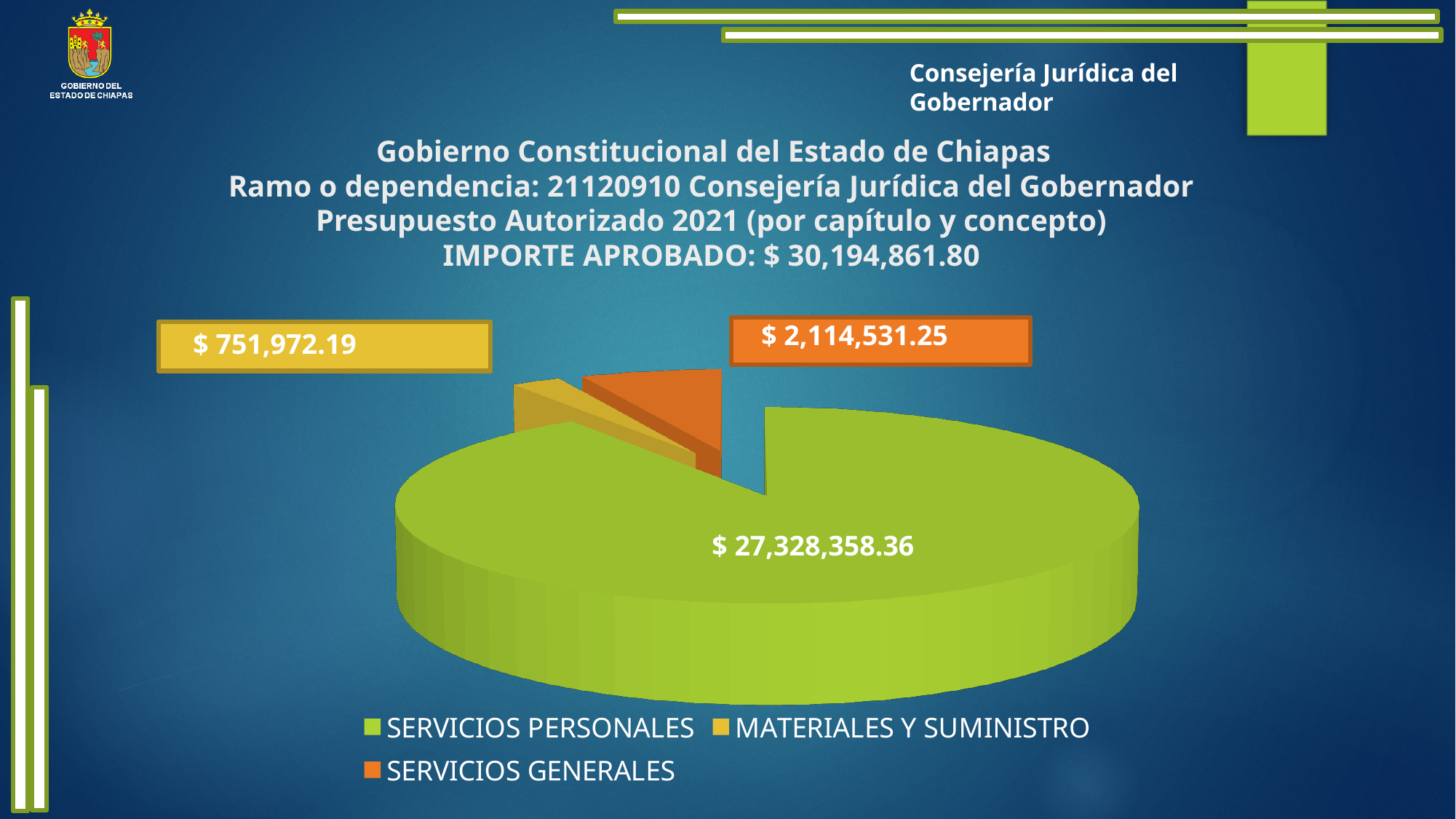
What is the difference between SERVICIOS PERSONALES and SERVICIOS GENERALES? $ 25,213,827.11 What is the value for SERVICIOS GENERALES? $ 2,114,531.25 Which is larger, SERVICIOS GENERALES or MATERIALES Y SUMINISTRO? SERVICIOS GENERALES What is the total approved amount (IMPORTE APROBADO) stated on the slide? $ 30,194,861.80 Which category has the largest slice of the pie? SERVICIOS PERSONALES How many categories does the pie chart show? 3 What is the value for SERVICIOS PERSONALES? $ 27,328,358.36 What is the difference between SERVICIOS GENERALES and MATERIALES Y SUMINISTRO? $ 1,362,559.06 Which category has the smallest slice of the pie? MATERIALES Y SUMINISTRO Which colour represents SERVICIOS GENERALES in the legend? Orange What is the value for MATERIALES Y SUMINISTRO? $ 751,972.19 What kind of chart is shown on the slide? Pie chart